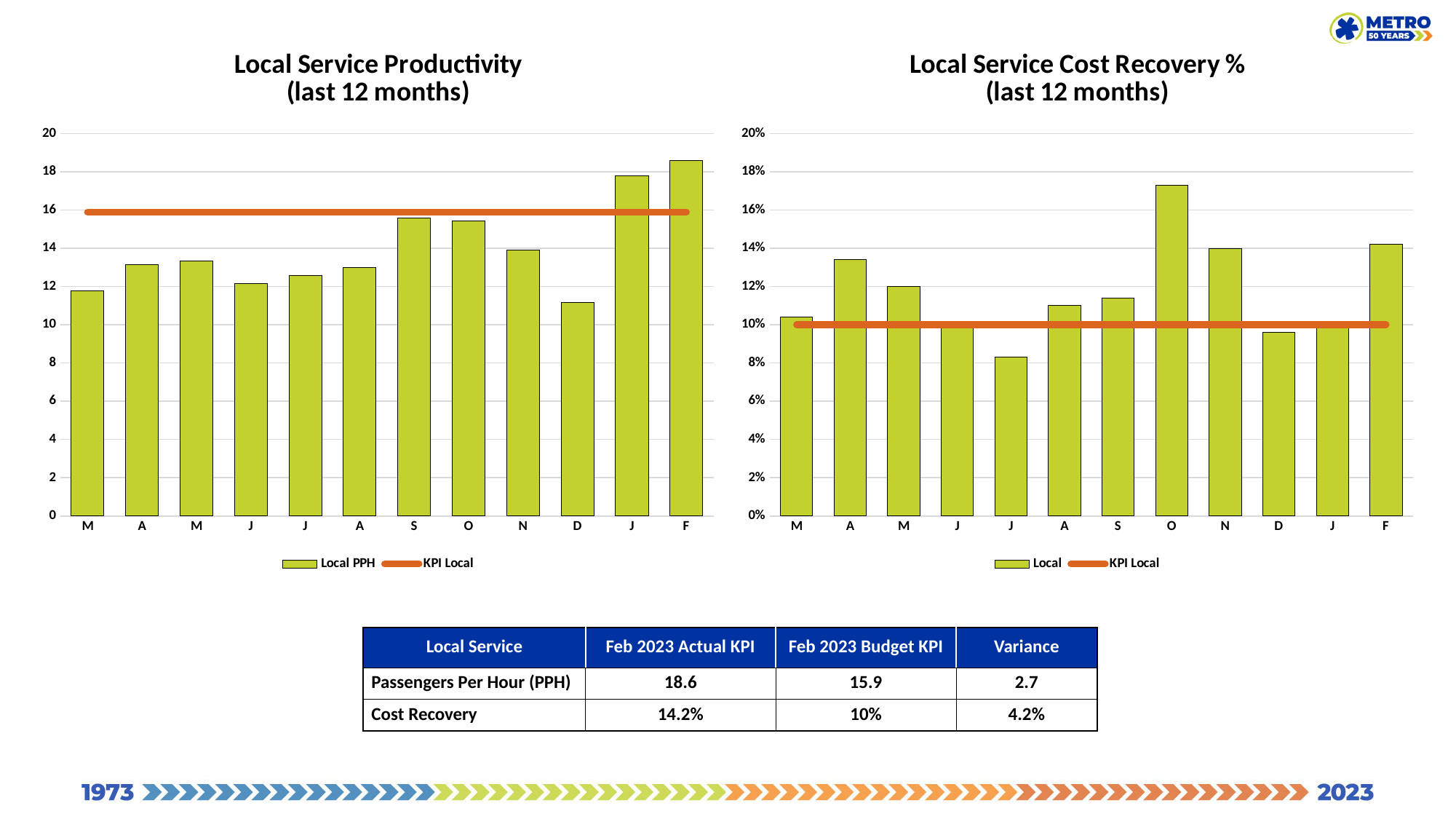
In the Local Service Cost Recovery % chart, what is the value for F (Feb 2023), as given in the table? 14.2% In the Local Service Productivity chart, is the value for S greater or less than 14? greater In the Local Service Productivity chart, which month has the highest bar? F In the Local Service Cost Recovery % chart, which is larger, the bar for N or the bar for D? N How many bars are plotted in the Local Service Cost Recovery % chart? 12 In the Local Service Productivity chart, which month has the lowest bar? D In the Local Service Productivity chart, what is the Local PPH value for F (Feb 2023), as given in the table? 18.6 How many series does the legend of the Local Service Productivity chart list? 2 In the Local Service Cost Recovery % chart, is the value for O greater or less than 16%? greater What are the two legend entries of the Local Service Cost Recovery % chart? Local and KPI Local What kind of chart is the Local Service Productivity chart? bar chart In the Local Service Cost Recovery % chart, which month has the highest bar? O